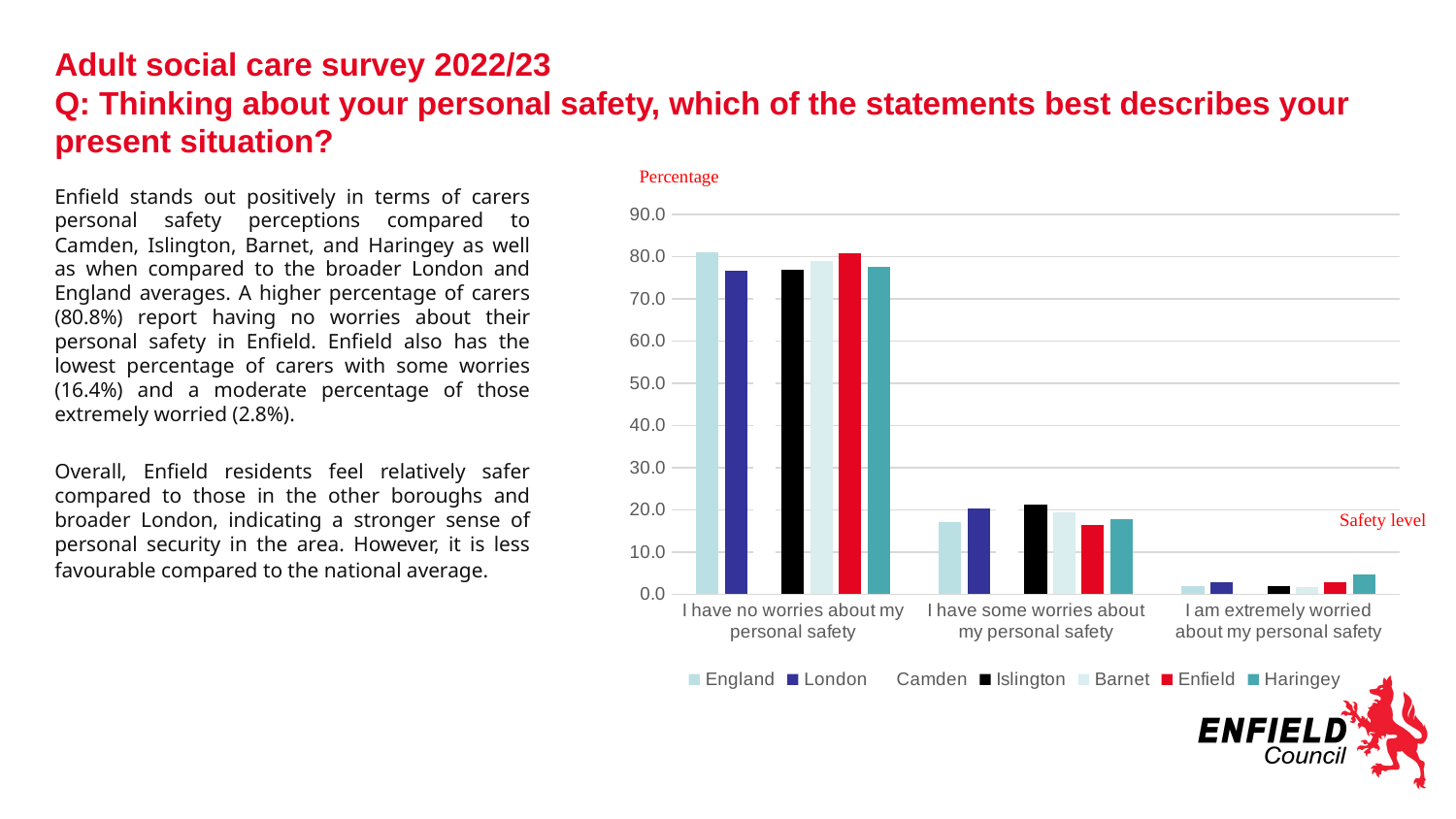
Is the value for London in 'I have no worries about my personal safety' greater or less than 80? less Which is larger: Islington's value for 'I have some worries about my personal safety' or England's value for the same statement? Islington Is the value for Haringey in 'I am extremely worried about my personal safety' greater or less than 10? less Is the value for Enfield in 'I have some worries about my personal safety' greater or less than 20? less What kind of chart is shown on the slide? bar chart How many categories (safety level statements) are shown on the x axis? 3 Do the bar values generally rise or fall moving from 'I have no worries' to 'I am extremely worried' along the x axis? fall How many series does the chart legend list? 7 What is the label on the vertical axis of the chart? Percentage